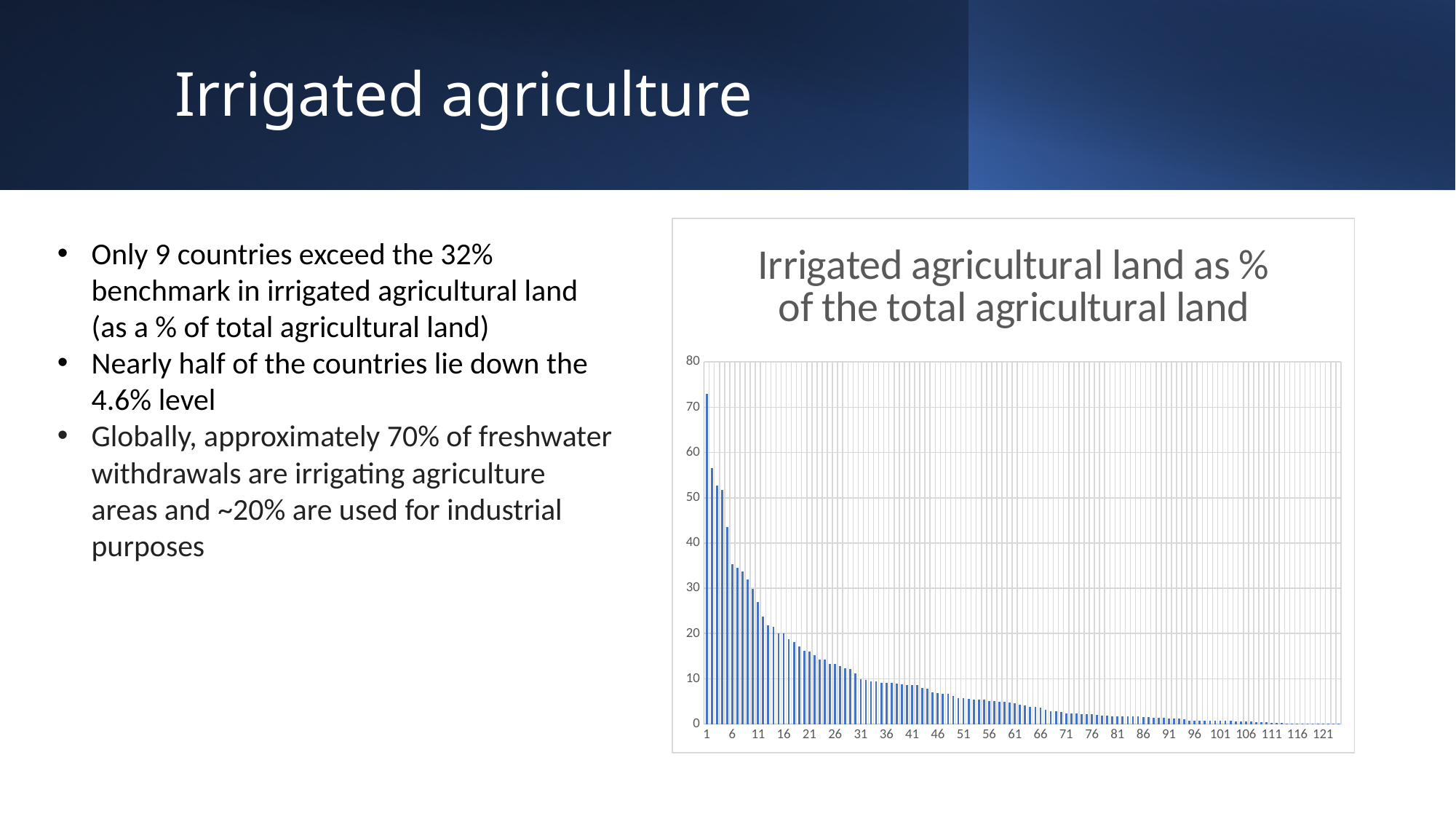
What kind of chart is shown on the slide? bar chart What is the highest value shown on the y axis? 80 Which category has the highest value in the chart? 1 Is the value for category 1 greater or less than 60? greater Is the value for category 11 greater or less than 20? greater Do the values rise or fall as you move from left to right along the x axis? fall Which is larger, the value for category 1 or the value for category 6? 1 Is the value for category 121 greater or less than 10? less Which is larger, the value for category 21 or the value for category 91? 21 What is the title of the chart? Irrigated agricultural land as % of the total agricultural land